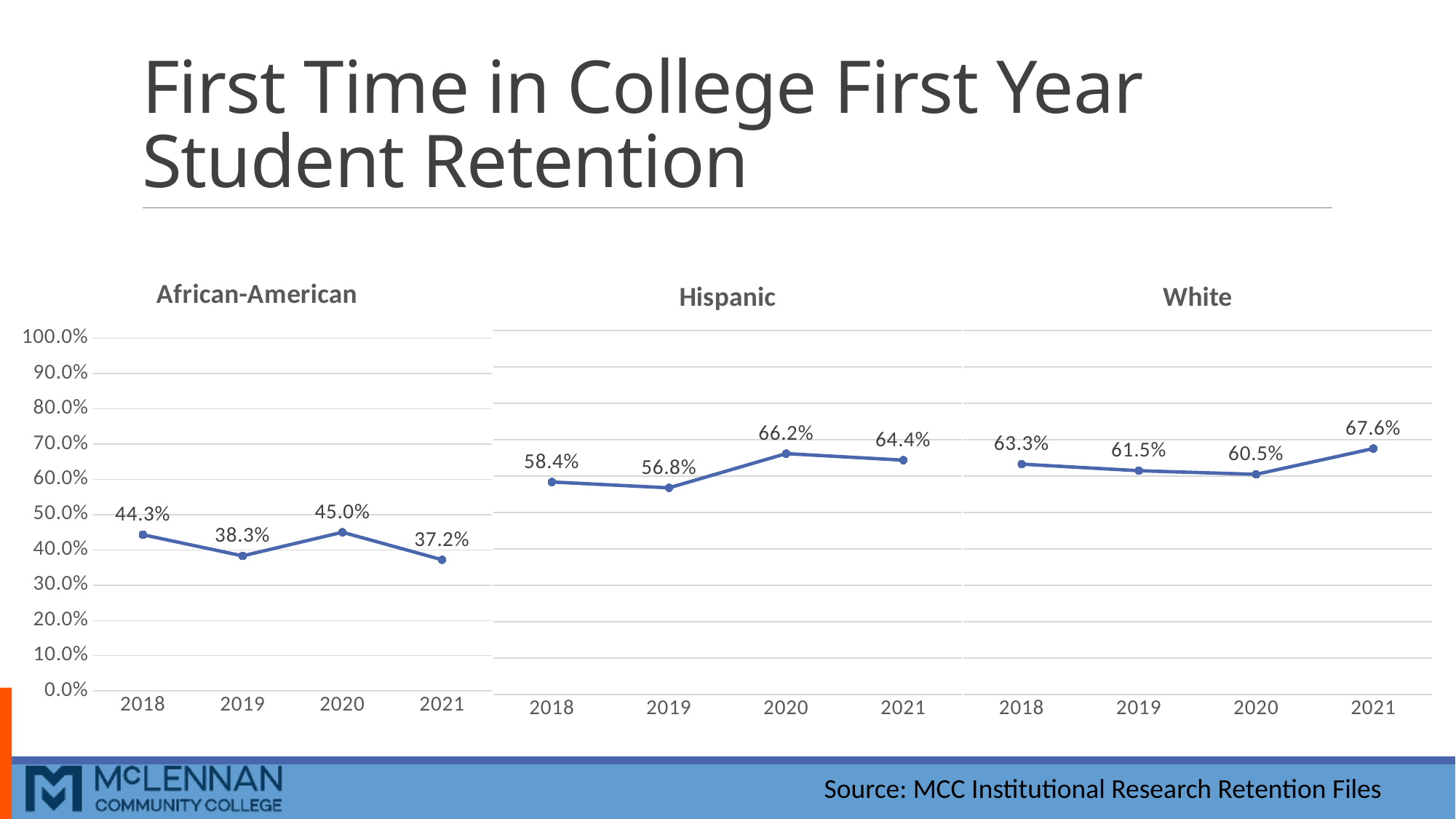
In the White chart, what is the retention value for 2021? 67.6% In the African-American chart, is the value for 2021 greater or less than 40.0%? less In the African-American chart, which year has the lowest retention value? 2021 In the Hispanic chart, is the value for 2018 larger or the value for 2021? 2021 In the African-American chart, what is the difference between the 2018 and 2019 values? 6.0% What type of chart is used for the White group? Line chart In the White chart, what is the difference between the 2021 and 2020 values? 7.1% How many years are plotted in the Hispanic chart? 4 In the Hispanic chart, what is the retention value for 2019? 56.8% In the Hispanic chart, which year has the highest retention value? 2020 In the African-American chart, what is the retention value for 2020? 45.0% In the White chart, which year has the lowest retention value? 2020